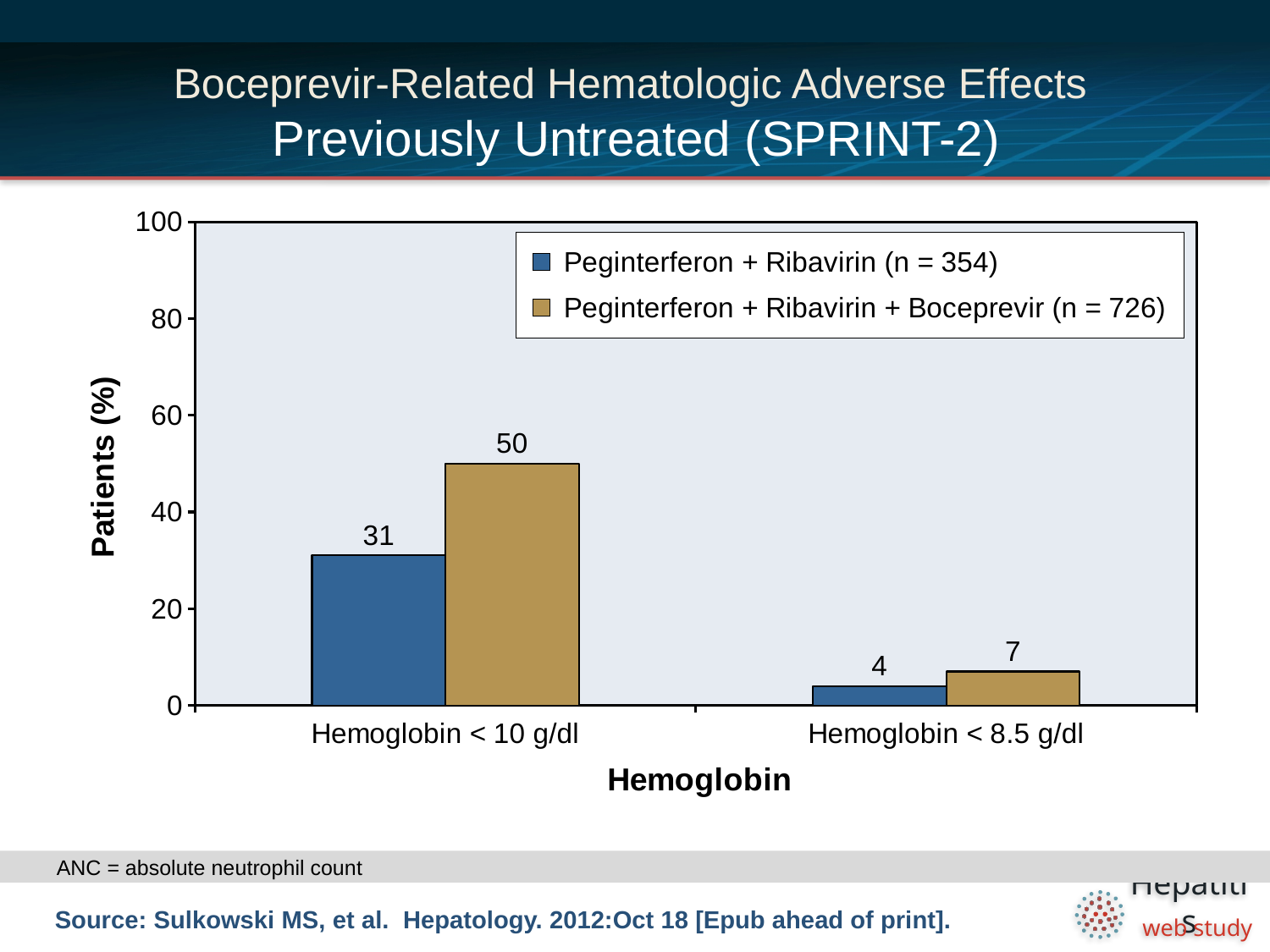
How many hemoglobin categories are shown on the x axis? 2 What kind of chart is shown on the slide? Bar chart What percentage of patients in the Peginterferon + Ribavirin (n = 354) group had Hemoglobin < 8.5 g/dl? 4 For Hemoglobin < 10 g/dl, which group has the larger value? Peginterferon + Ribavirin + Boceprevir (n = 726) What percentage of patients in the Peginterferon + Ribavirin (n = 354) group had Hemoglobin < 10 g/dl? 31 What is the difference between the two groups for Hemoglobin < 10 g/dl? 19 What is the difference between the two groups for Hemoglobin < 8.5 g/dl? 3 Which bar in the chart has the lowest value? Peginterferon + Ribavirin, Hemoglobin < 8.5 g/dl How many series does the legend list? 2 What percentage of patients in the Peginterferon + Ribavirin + Boceprevir (n = 726) group had Hemoglobin < 10 g/dl? 50 Which bar in the chart has the highest value? Peginterferon + Ribavirin + Boceprevir, Hemoglobin < 10 g/dl What percentage of patients in the Peginterferon + Ribavirin + Boceprevir (n = 726) group had Hemoglobin < 8.5 g/dl? 7